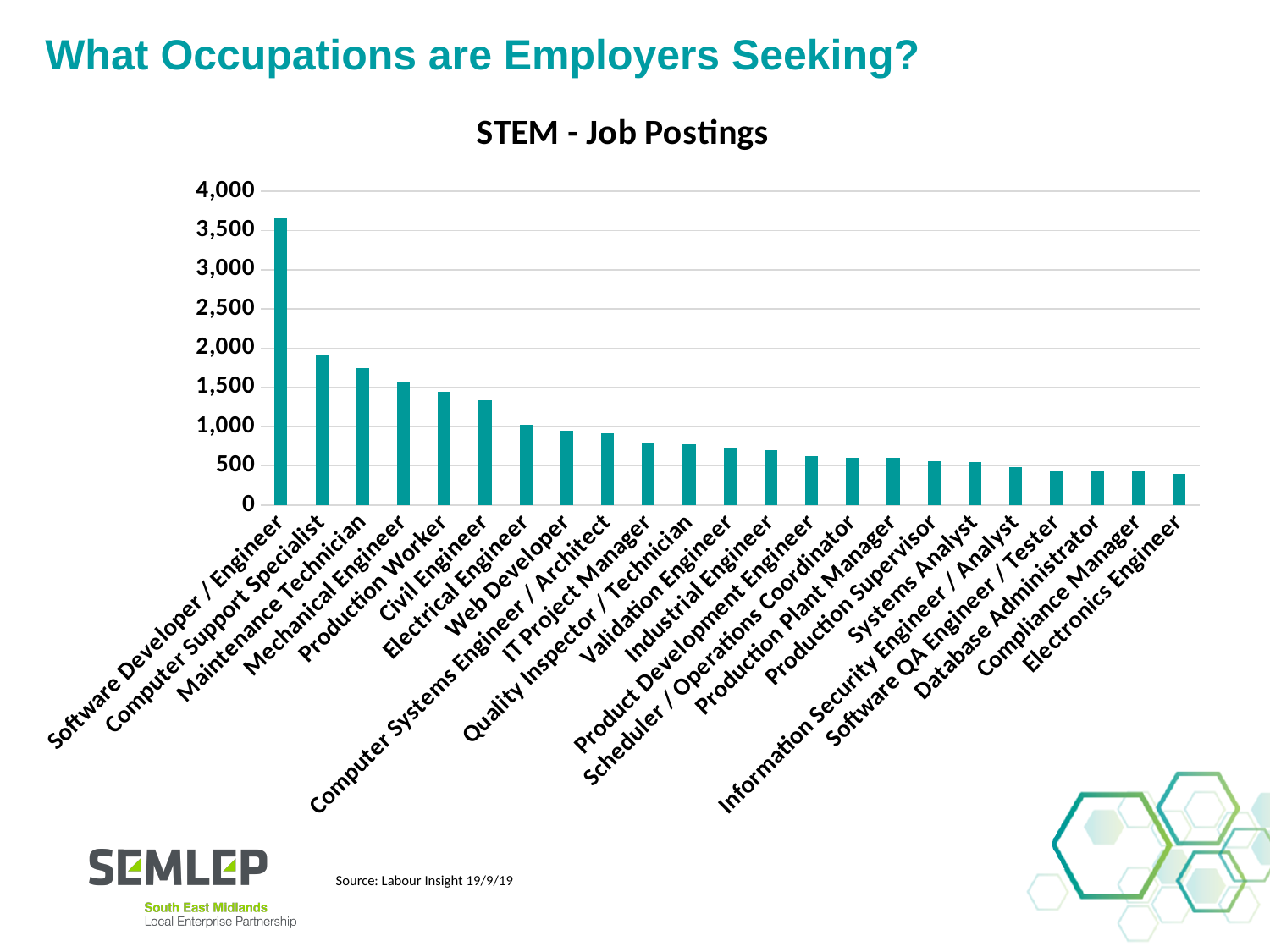
Is the value for Validation Engineer greater or less than 500? greater Which has more job postings, Civil Engineer or Web Developer? Civil Engineer What is the title of the chart? STEM - Job Postings Which occupation has the highest number of job postings? Software Developer / Engineer Which has more job postings, Computer Support Specialist or Mechanical Engineer? Computer Support Specialist What type of chart is shown on the slide? Bar chart Is the value for Electronics Engineer greater or less than 500? less Is the value for Civil Engineer greater or less than 1,000? greater Do the values rise or fall moving from left to right along the x axis? Fall How many occupations are plotted in the chart? 23